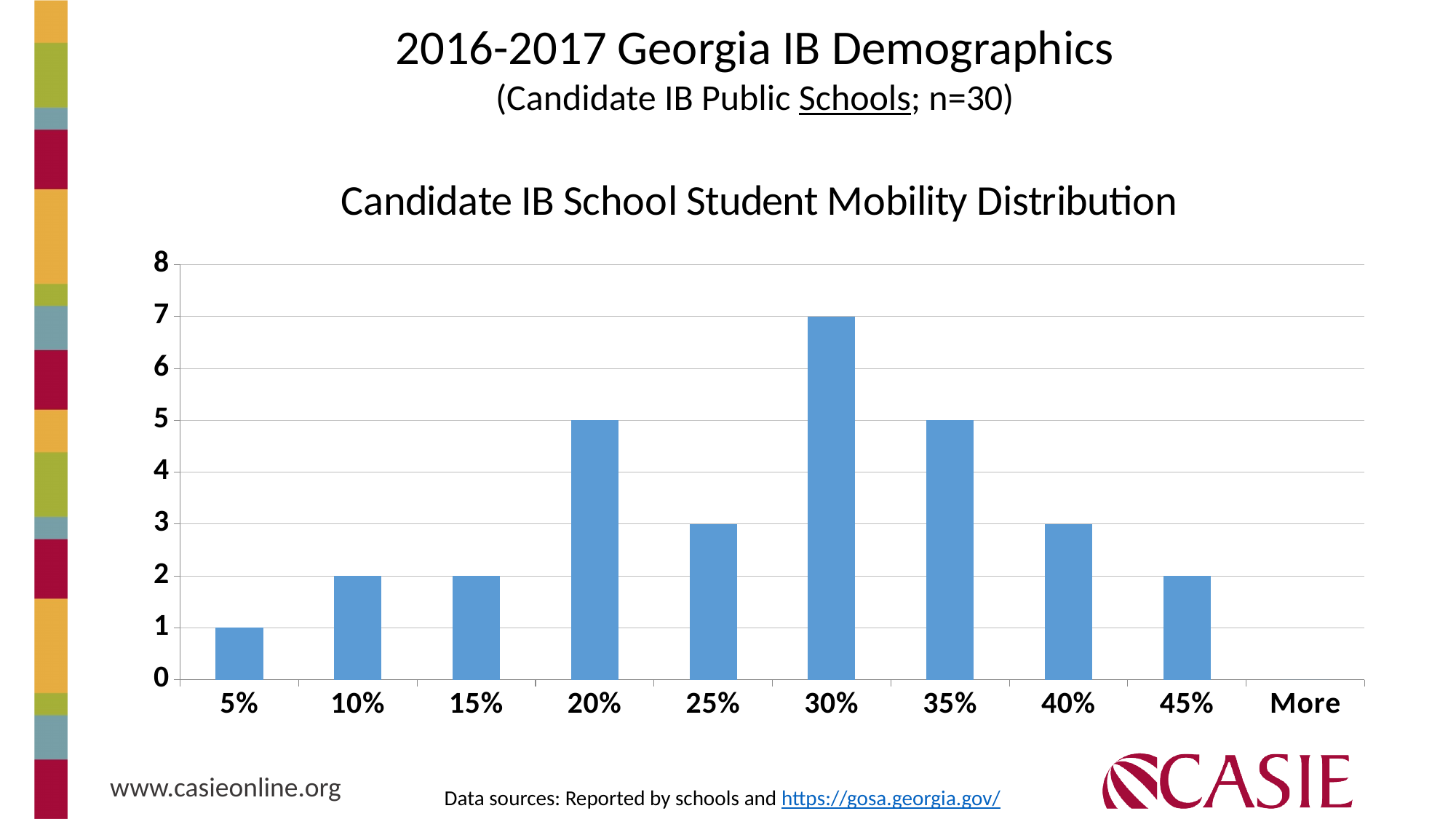
What is the value of the bar for 30%? 7 What kind of chart is shown on the slide? bar chart How many categories are shown on the x axis of the chart? 10 What is the difference between the values for 30% and 35%? 2 What is the value of the bar for 40%? 3 Is the value for 20% greater or less than 4? greater Which category has the highest bar in the chart? 30% Which is larger, the value for 25% or the value for 45%? 25% What is the value shown for the 'More' category? 0 What is the value of the bar for 5%? 1 What is the value of the bar for 20%? 5 What is the title of the chart? Candidate IB School Student Mobility Distribution